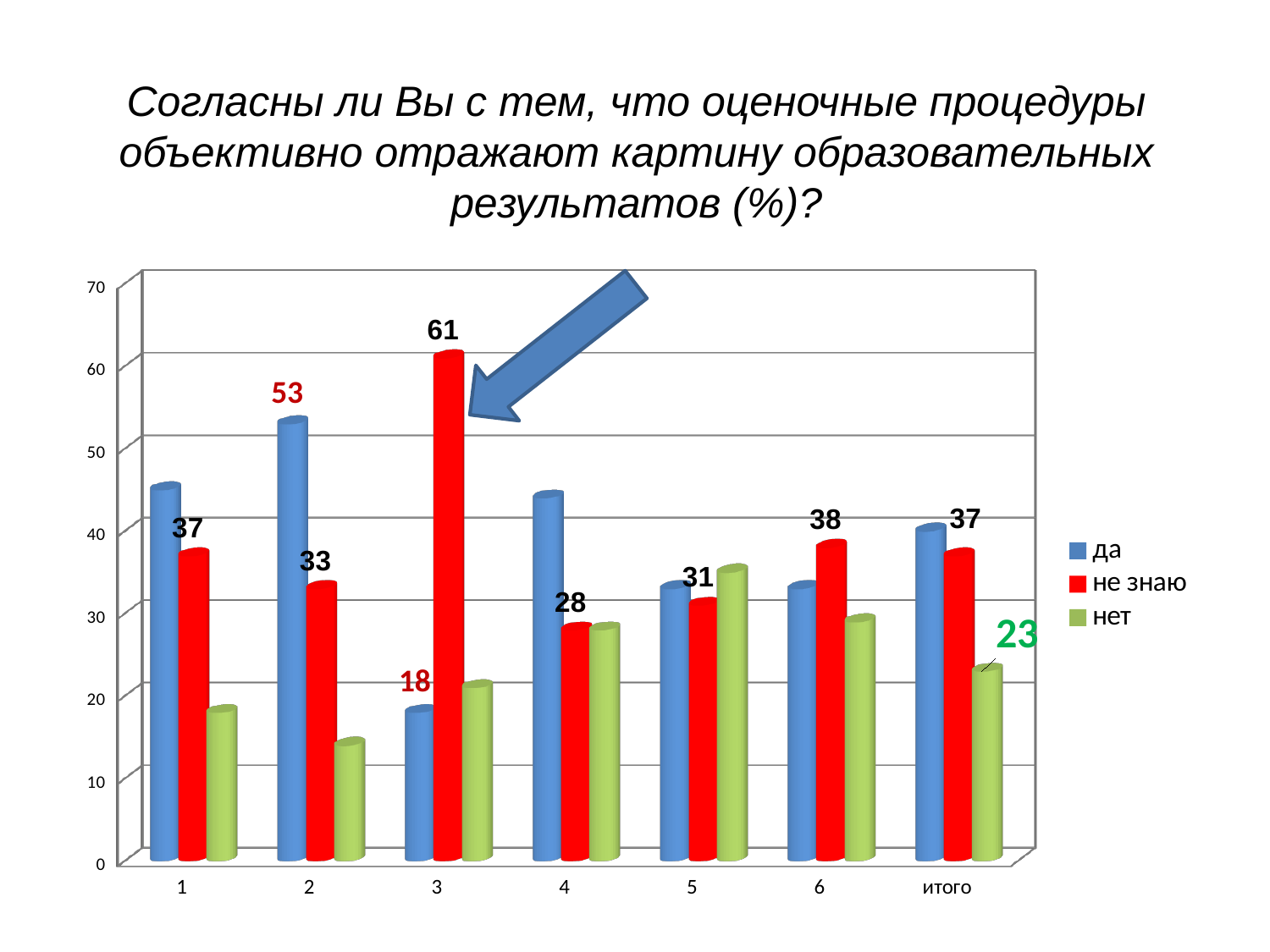
Which is larger: the "не знаю" value for category 6 or for category 5? category 6 What is the value of the "да" series for category 3? 18 What is the value of the "да" series for category 2? 53 Which category has the highest value for the "не знаю" series? 3 What kind of chart is shown on the slide? bar chart What is the value of the "нет" series for "итого"? 23 What is the value of the "не знаю" series for category 3? 61 Is the value of the "да" series for category 1 greater or less than 40? greater How many categories are shown on the x axis? 7 What is the difference between the "не знаю" value and the "да" value for category 3? 43 What is the value of the "не знаю" series for "итого"? 37 How many series does the legend list? 3